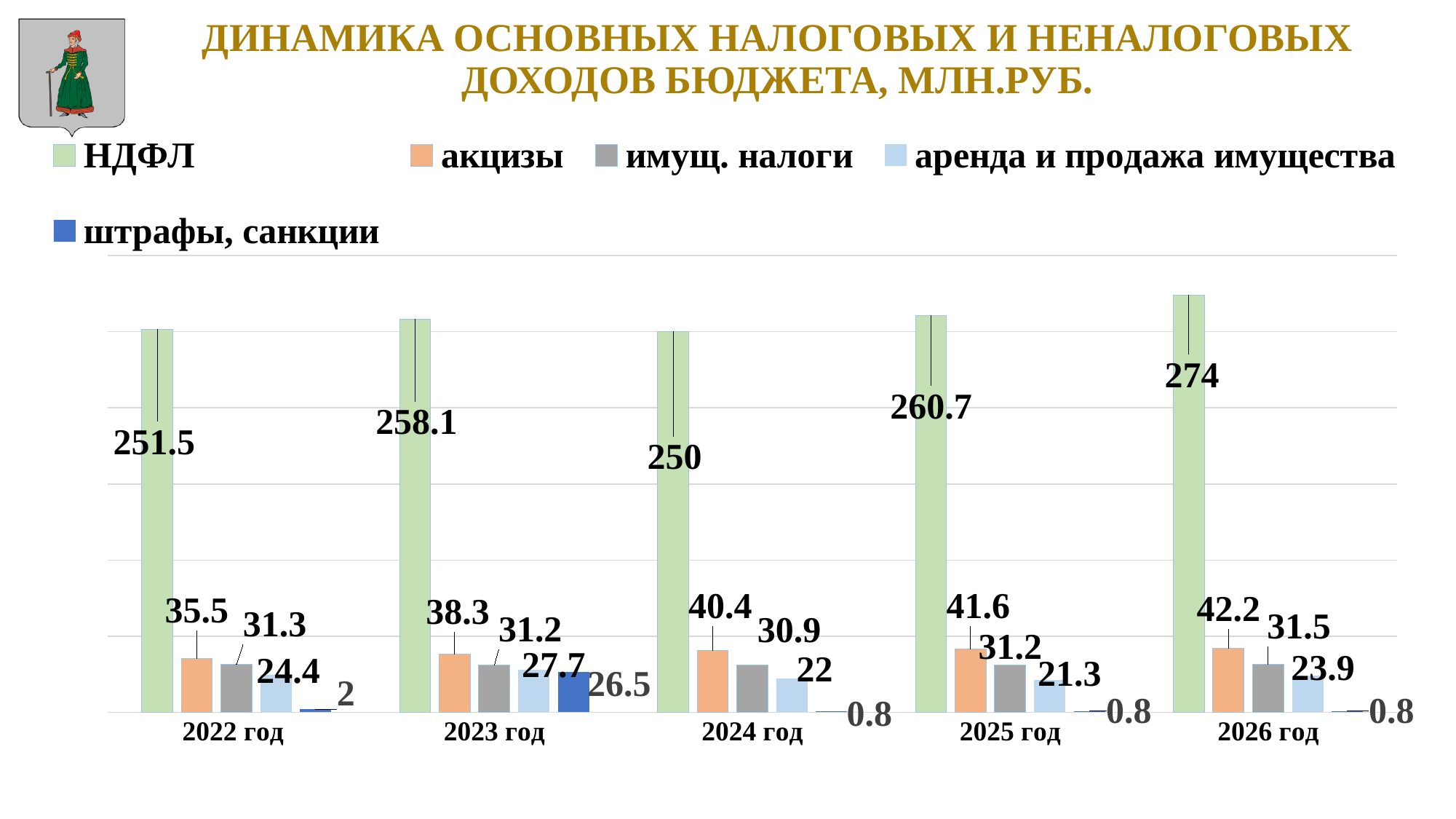
Does the value of акцизы rise or fall from 2022 год to 2026 год? rise How many series does the legend list? 5 What type of chart is shown on the slide? bar chart In which year is НДФЛ the highest? 2026 год What is the value of акцизы for 2023 год? 38.3 What is the difference between НДФЛ in 2026 год and 2022 год? 22.5 What is the value of штрафы, санкции for 2023 год? 26.5 What is the value of аренда и продажа имущества for 2025 год? 21.3 What is the value of НДФЛ for 2026 год? 274 In which year is НДФЛ the lowest? 2024 год How many year categories are shown on the x axis? 5 Which is larger: акцизы in 2024 год or имущ. налоги in 2024 год? акцизы